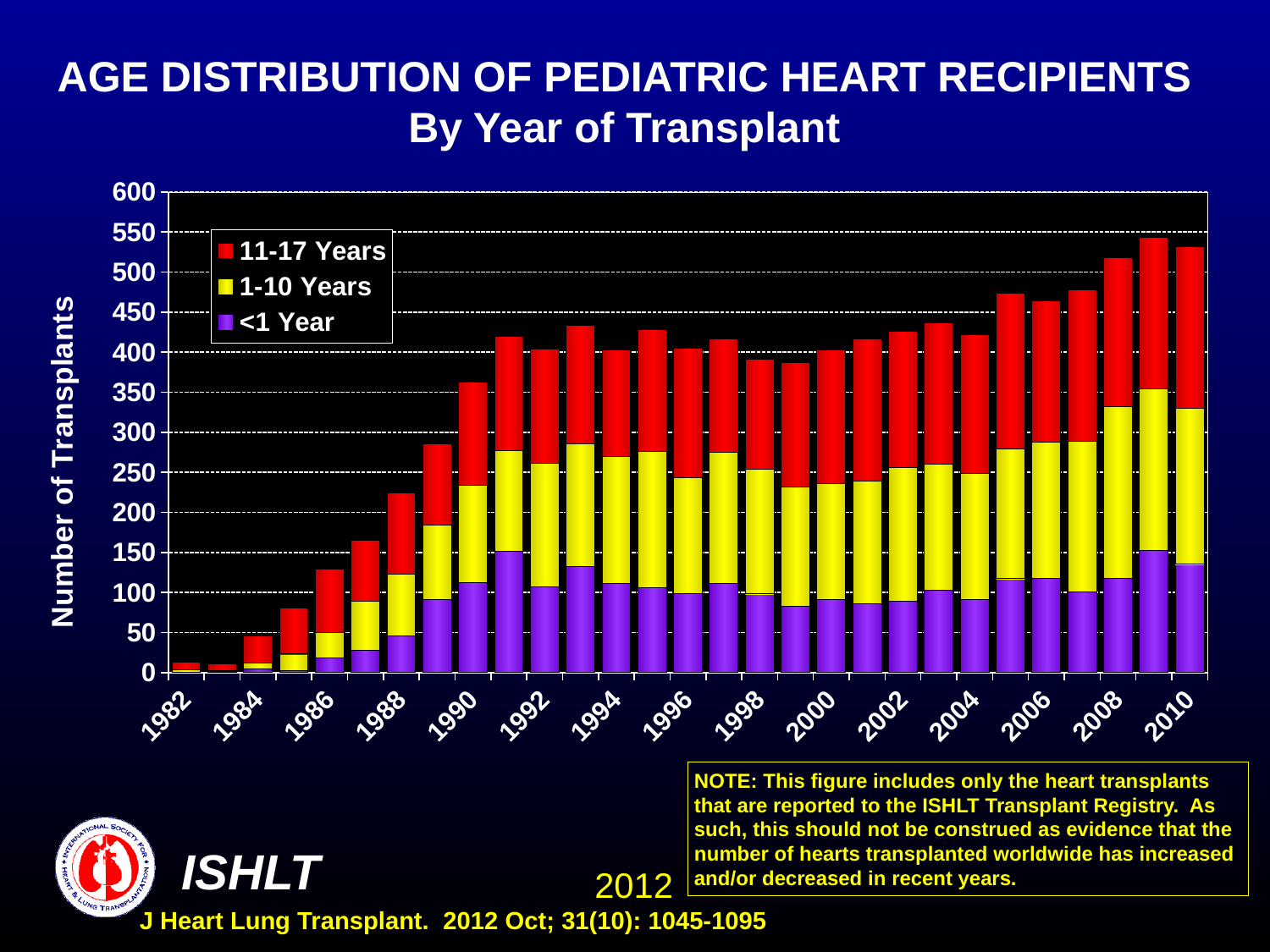
Is the total number of transplants in 1982 greater or less than 50? less Which age groups are listed in the legend? 11-17 Years, 1-10 Years, <1 Year Is the total number of transplants in 2009 greater or less than 500? greater What kind of chart is shown on the slide? Stacked bar chart Which year has a higher total number of transplants, 2003 or 2007? 2007 Overall, do the total number of transplants rise or fall from 1982 to 2010? Rise Is the total number of transplants in 1988 greater or less than 200? greater Which colour represents the <1 Year age group? Purple How many series does the legend list? 3 Which year has a higher total number of transplants, 1989 or 1990? 1990 Which year has the highest total number of transplants? 2009